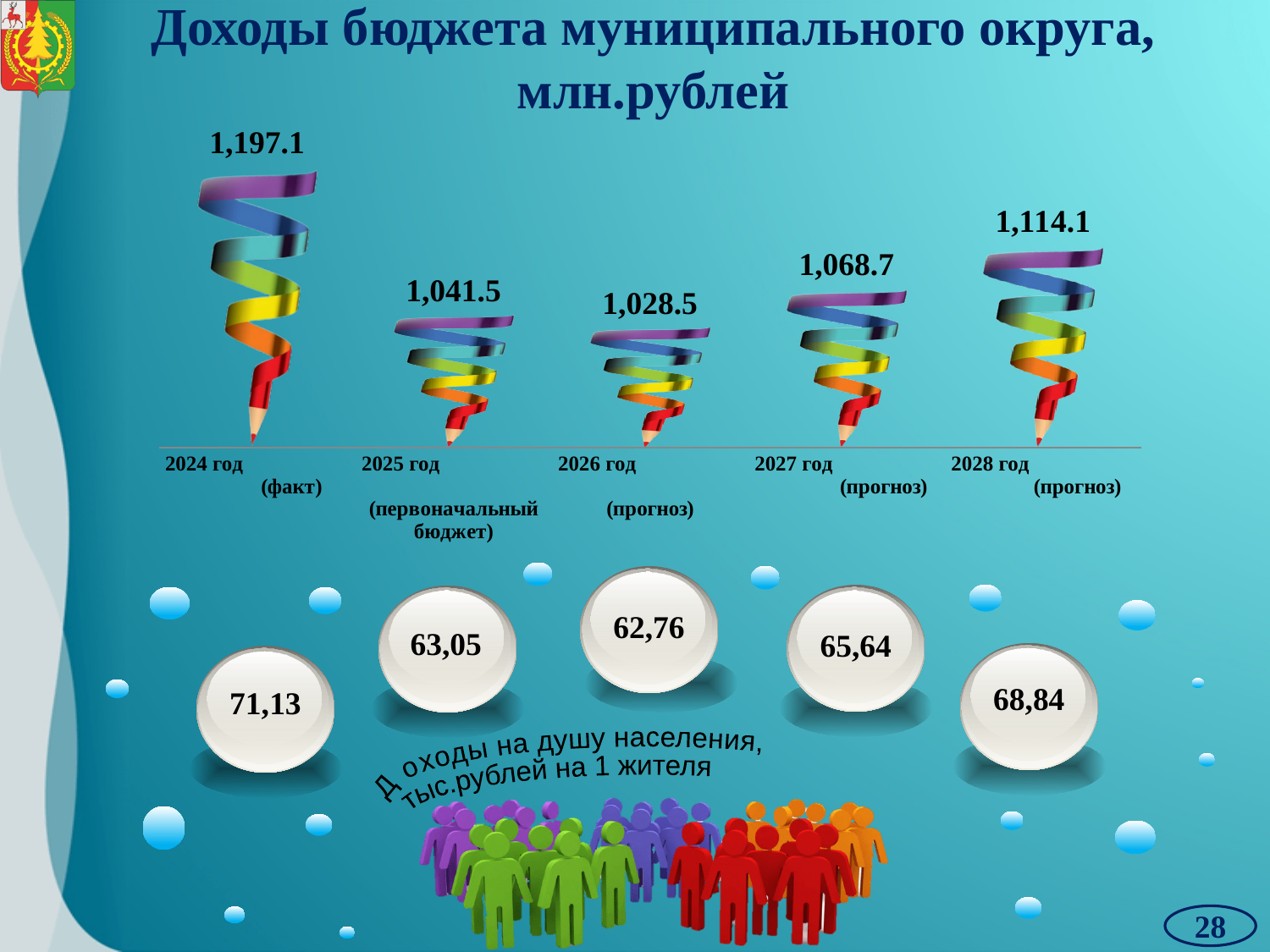
Which year has the lowest budget revenue on the chart? 2026 год Do the budget revenue values rise or fall from 2026 год to 2028 год? rise In the per-capita income circles (Доходы на душу населения), which year has the lowest value? 2026 год In the per-capita income circles (Доходы на душу населения), what is the value for 2024 год? 71,13 What is the difference between the budget revenue for 2028 год and 2027 год? 45.4 How many years are shown on the budget revenue chart? 5 What is the budget revenue value shown for 2024 год (факт)? 1,197.1 Which is larger, the budget revenue for 2027 год or for 2025 год? 2027 год What is the budget revenue value shown for 2026 год (прогноз)? 1,028.5 What is the budget revenue value shown for 2028 год (прогноз)? 1,114.1 What is the difference between the budget revenue for 2024 год and 2025 год? 155.6 Which year has the highest budget revenue on the chart? 2024 год